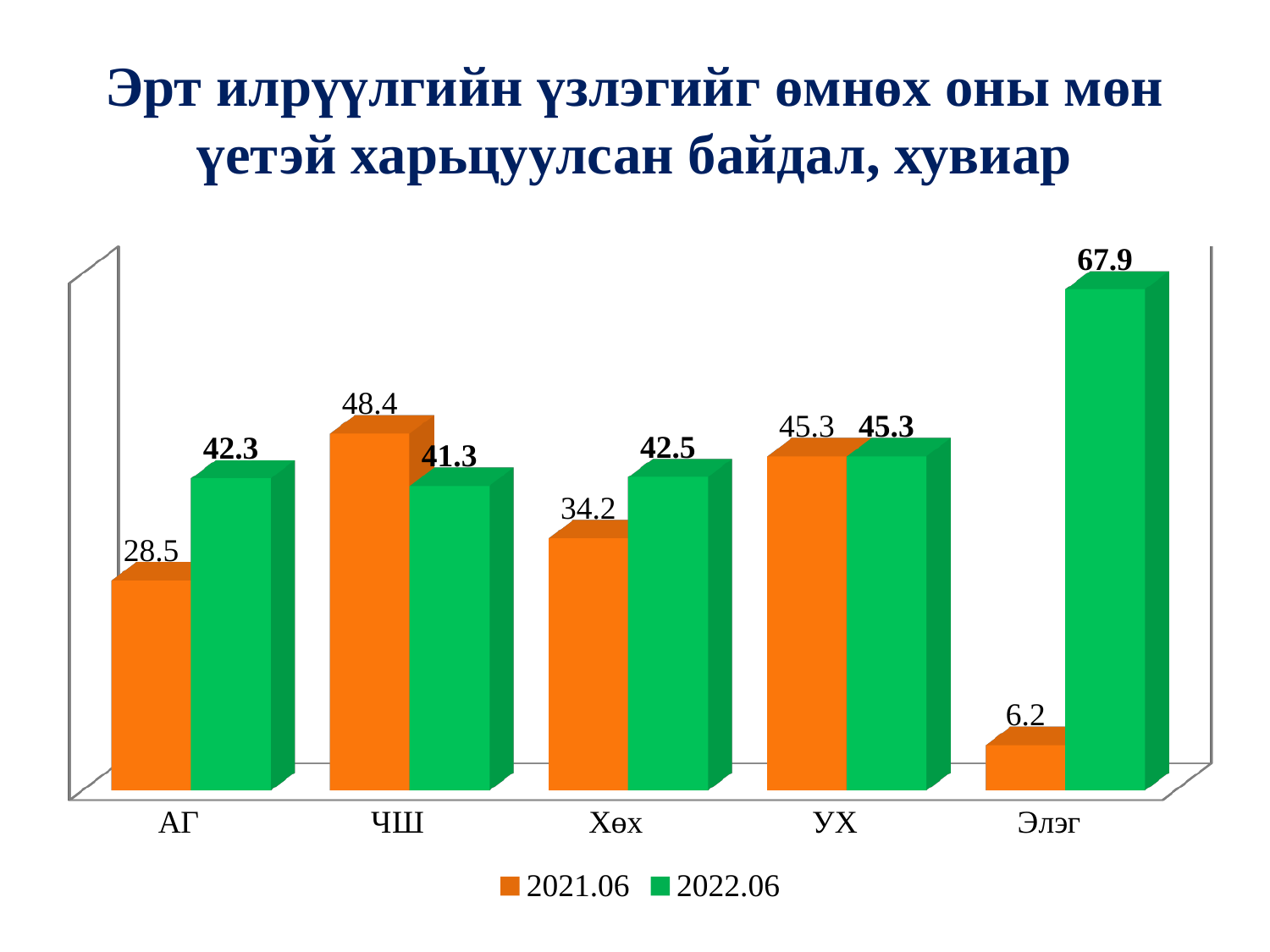
What is the difference between the 2021.06 and 2022.06 values for ЧШ? 7.1 What kind of chart is shown on the slide? Bar chart What is the value for Элэг in the 2021.06 series? 6.2 What is the value for ЧШ in the 2021.06 series? 48.4 What is the difference between the 2022.06 and 2021.06 values for Элэг? 61.7 How many series does the legend list? 2 Which category has the highest value in the 2021.06 series? ЧШ What is the value for АГ in the 2022.06 series? 42.3 For Хөх, which series has the larger value, 2021.06 or 2022.06? 2022.06 How many categories are shown on the x axis? 5 Which category has the highest value in the 2022.06 series? Элэг Which category has the lowest value in the 2021.06 series? Элэг